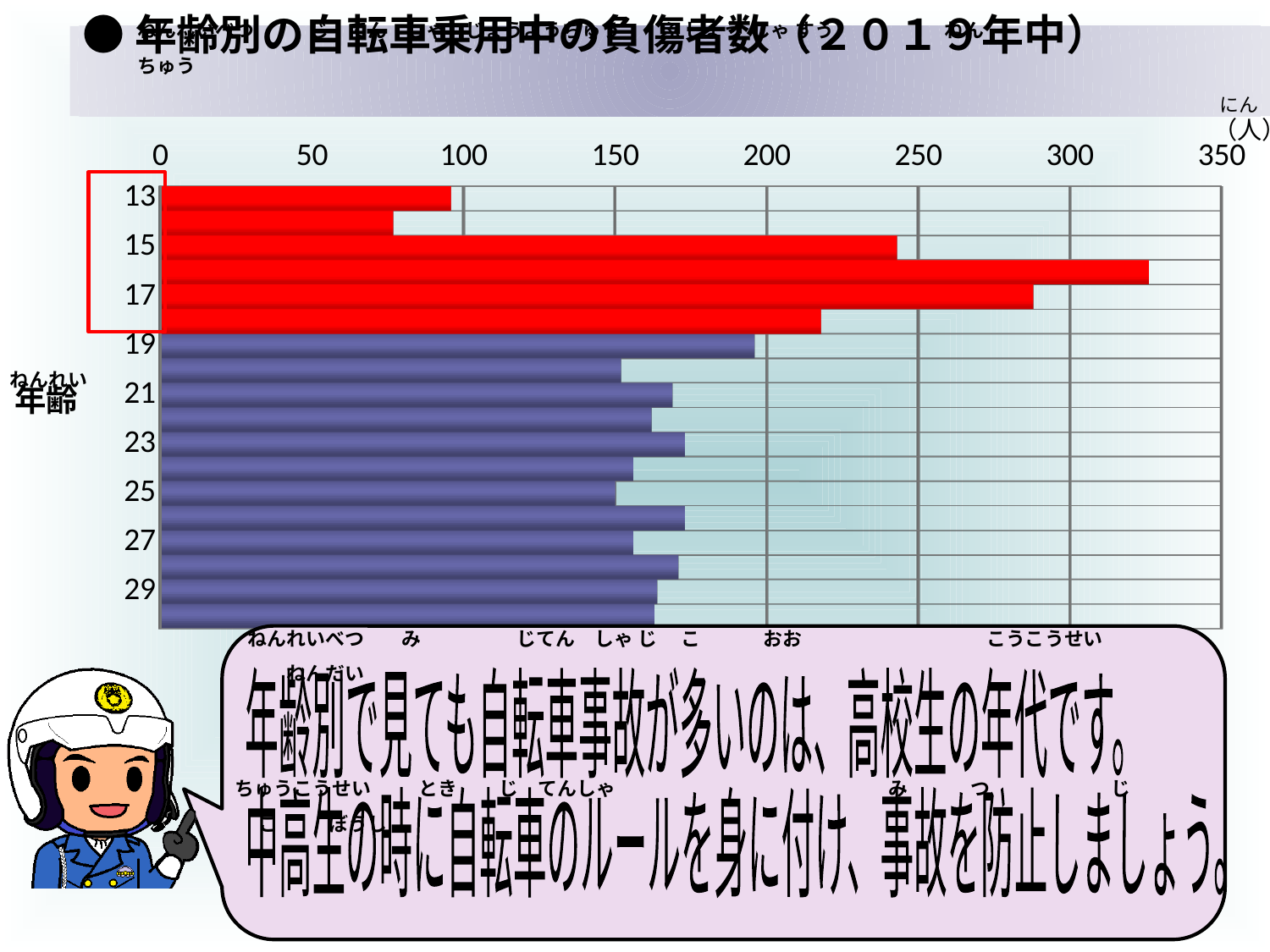
Which has a larger value, age 17 or age 21? age 17 Is the value for age 13 greater or less than 100? less What is the highest value shown on the horizontal axis of the chart? 350 What is the title of the chart? 年齢別の自転車乗用中の負傷者数（２０１９年中） Is the value for age 29 greater or less than 200? less Is the value for age 21 greater or less than 150? greater Do the values rise or fall going from age 13 to age 17? rise What kind of chart is shown on the slide? bar chart What unit is shown for the horizontal axis of the chart? 人 Which has a larger value, age 13 or age 15? age 15